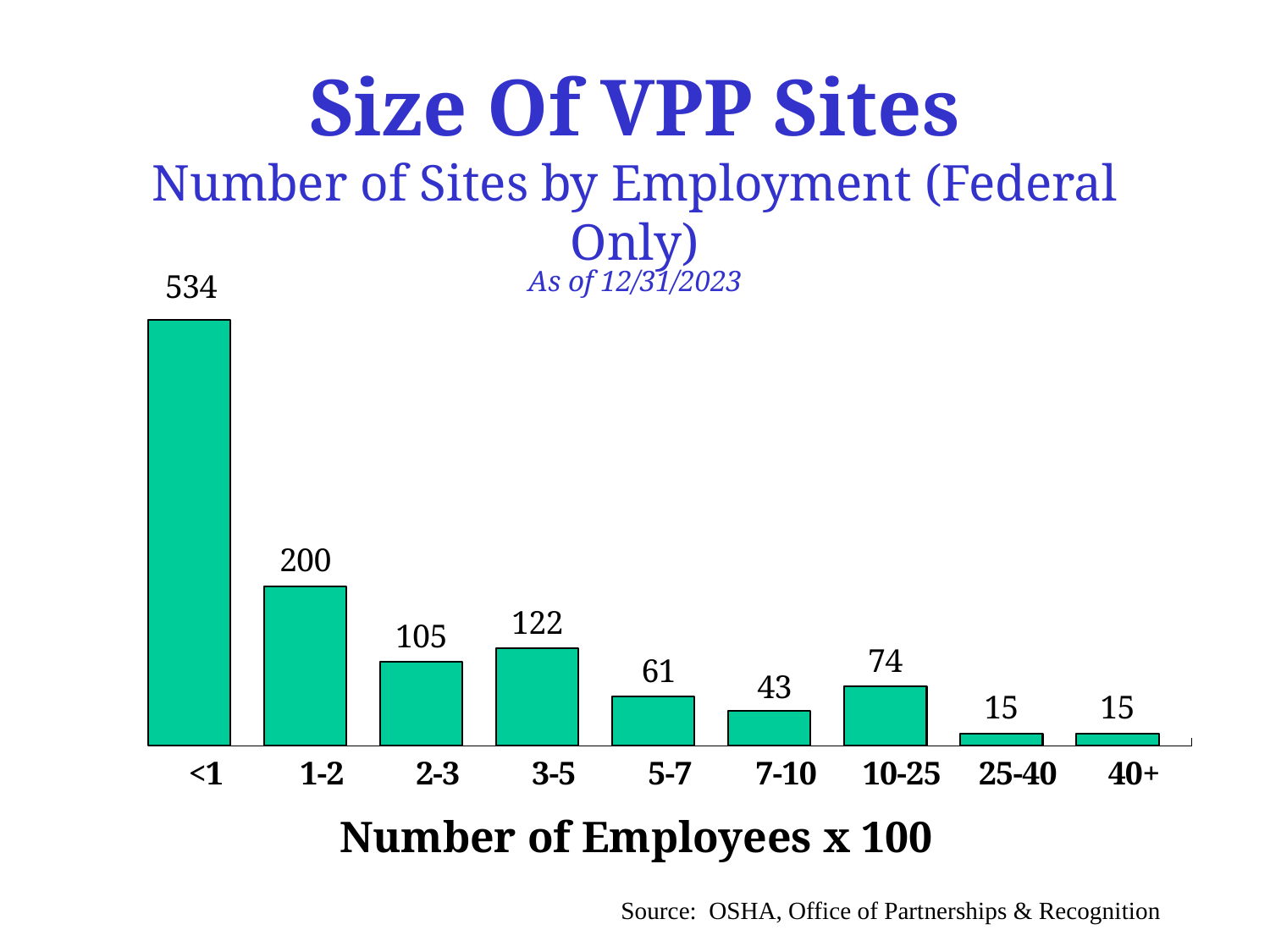
What is the number of sites in the '10-25' employment category? 74 What is the value shown for the '3-5' category? 122 What kind of chart is shown on the slide? Bar chart What is the difference between the '3-5' and '2-3' categories? 17 Which categories have the lowest number of sites? 25-40 and 40+ How many employment categories are shown on the x axis? 9 What is the x-axis label of the chart? Number of Employees x 100 How many VPP sites have fewer than 100 employees (the '<1' category)? 534 Which employment category has the highest number of sites? <1 Which has more sites, the '5-7' category or the '7-10' category? 5-7 What is the difference between the number of sites in the '<1' category and the '1-2' category? 334 As of what date is the data on the chart reported? 12/31/2023